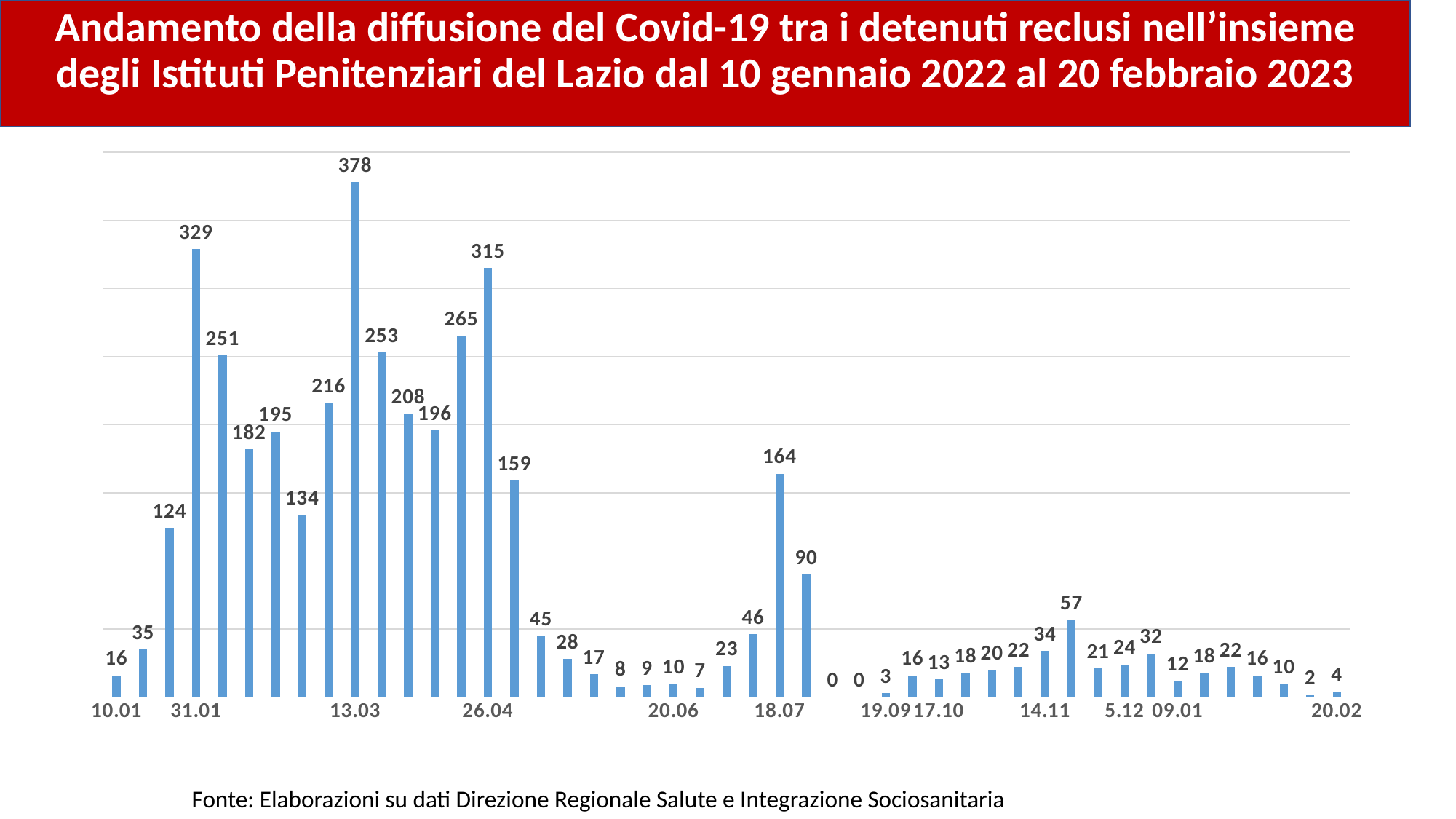
What is the value for 20.02? 4 What is the value for 26.04? 315 What is the value for 31.01? 329 What type of chart is shown on the slide? bar chart Which is larger, the value for 31.01 or the value for 26.04? 31.01 What is the value for 18.07? 164 What is the value for 13.03? 378 Which date has the highest value? 13.03 Do the values generally rise or fall from 13.03 to 20.06? fall What is the highest value shown in the chart? 378 What is the difference between the values for 13.03 and 31.01? 49 What is the value for 10.01? 16